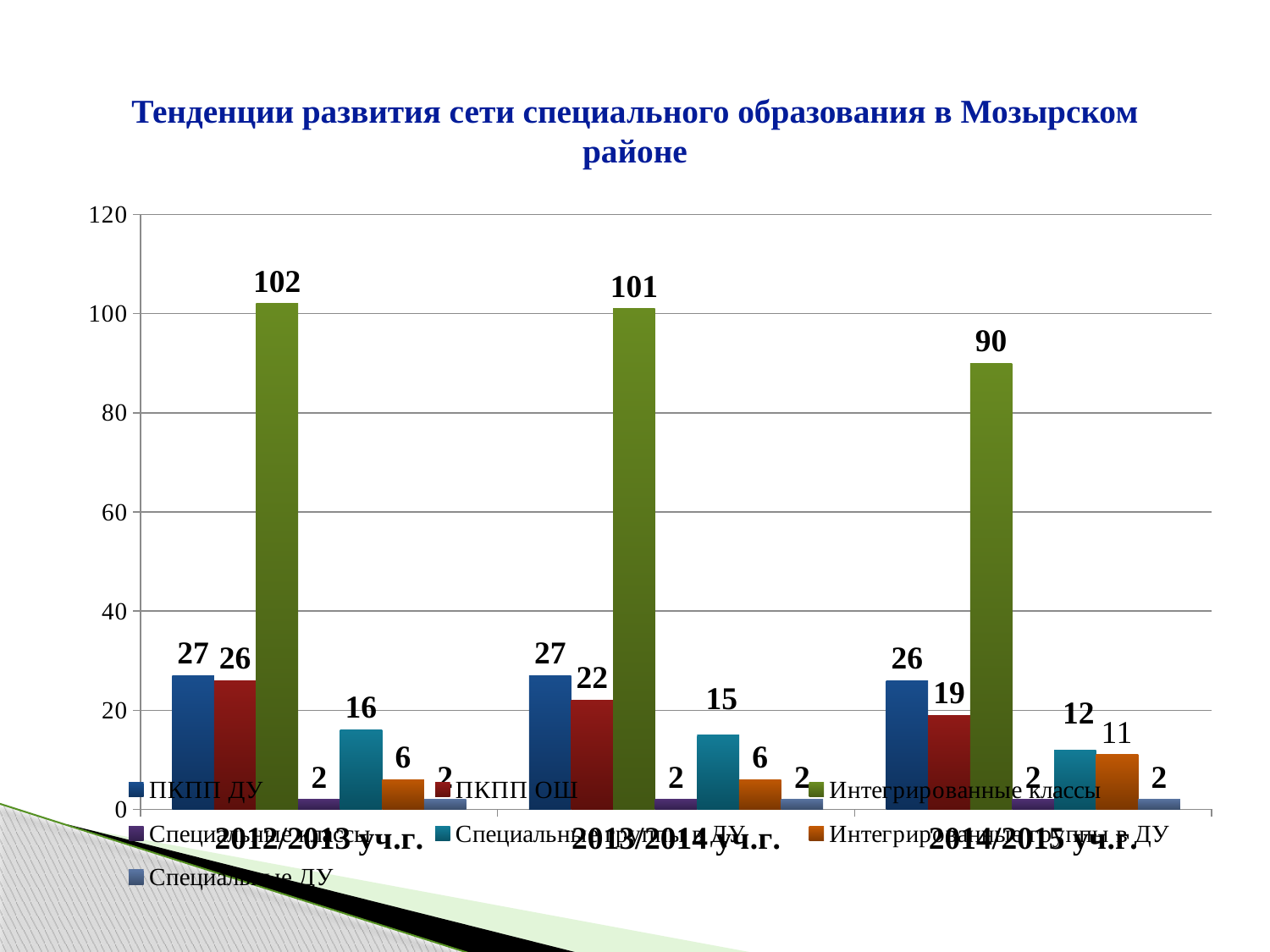
What is the value for ПКПП ДУ in 2014/2015 уч.г.? 26 What is the value for Интегрированные классы in 2014/2015 уч.г.? 90 How many school-year categories are shown on the x axis? 3 Which is larger: ПКПП ОШ in 2012/2013 уч.г. or ПКПП ОШ in 2014/2015 уч.г.? ПКПП ОШ in 2012/2013 уч.г. Do the values for ПКПП ОШ rise or fall from 2012/2013 уч.г. to 2014/2015 уч.г.? fall What is the value for Интегрированные группы в ДУ in 2014/2015 уч.г.? 11 What is the value for ПКПП ОШ in 2013/2014 уч.г.? 22 In which school year is the value for Интегрированные классы the lowest? 2014/2015 уч.г. What is the value for Интегрированные классы in 2012/2013 уч.г.? 102 How many series does the legend list? 7 What kind of chart is shown on the slide? bar chart What is the difference between the Интегрированные классы values for 2012/2013 уч.г. and 2014/2015 уч.г.? 12